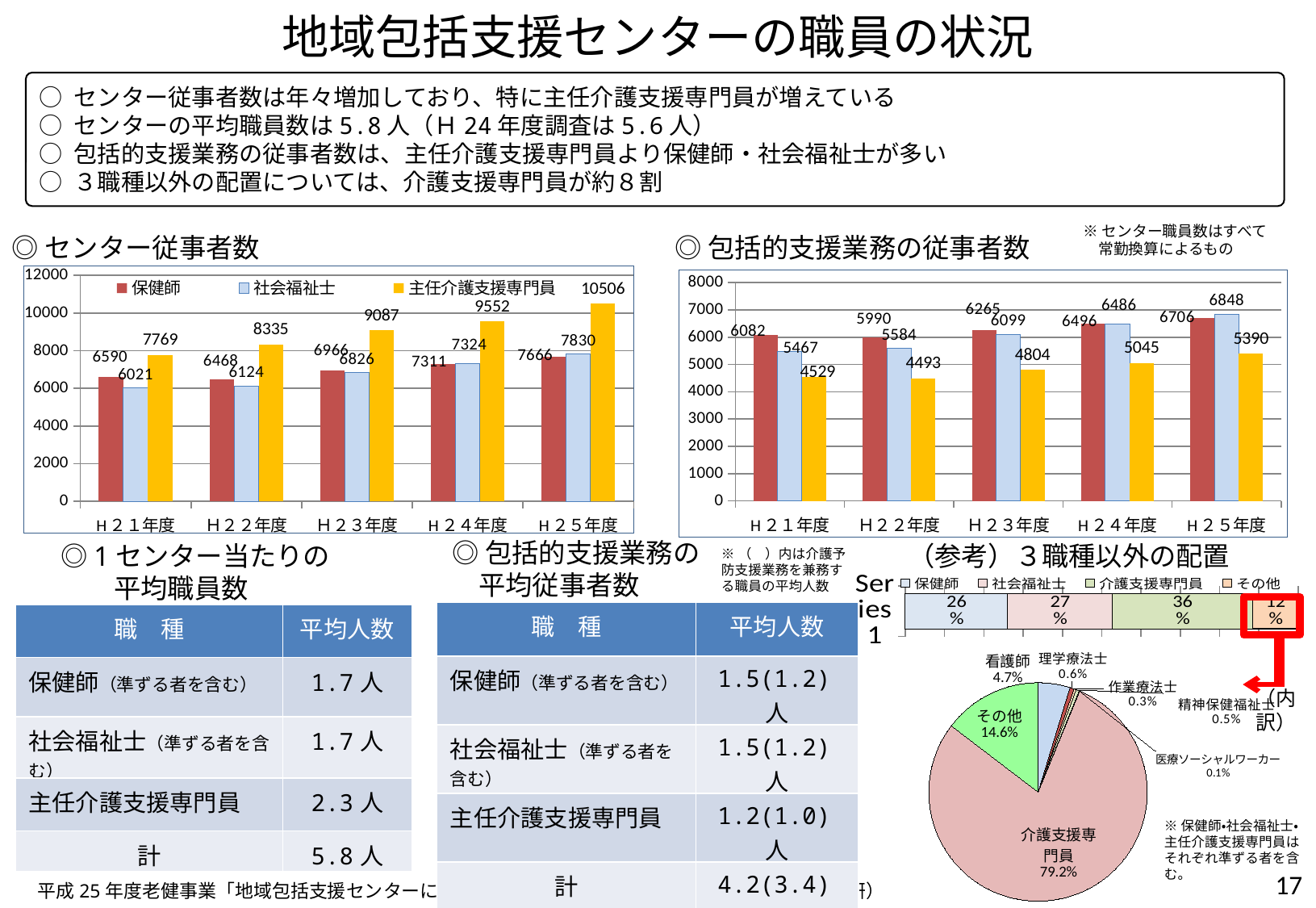
In the 包括的支援業務の従事者数 chart, which is larger in Ｈ２１年度, 保健師 or 主任介護支援専門員? 保健師 In the pie chart at the bottom right, what is the share of 介護支援専門員? 79.2% What kind of chart is the 包括的支援業務の従事者数 chart? bar chart In the 包括的支援業務の従事者数 chart, which year has the highest value for 社会福祉士? Ｈ２５年度 In the 包括的支援業務の従事者数 chart, what is the value for 主任介護支援専門員 in Ｈ２２年度? 4493 In the 包括的支援業務の従事者数 chart, how many fiscal years are shown on the x axis? 5 In the センター従事者数 chart, how many series does the legend list? 3 In the センター従事者数 chart, does the value for 主任介護支援専門員 rise or fall from Ｈ２１年度 to Ｈ２５年度? rise In the （参考）３職種以外の配置 stacked bar, what is the share for 介護支援専門員? 36% In the センター従事者数 chart, what is the difference between 主任介護支援専門員 and 社会福祉士 in Ｈ２５年度? 2676 In the センター従事者数 chart, what is the value for 保健師 in Ｈ２１年度? 6590 In the センター従事者数 chart, what is the value for 主任介護支援専門員 in Ｈ２５年度? 10506